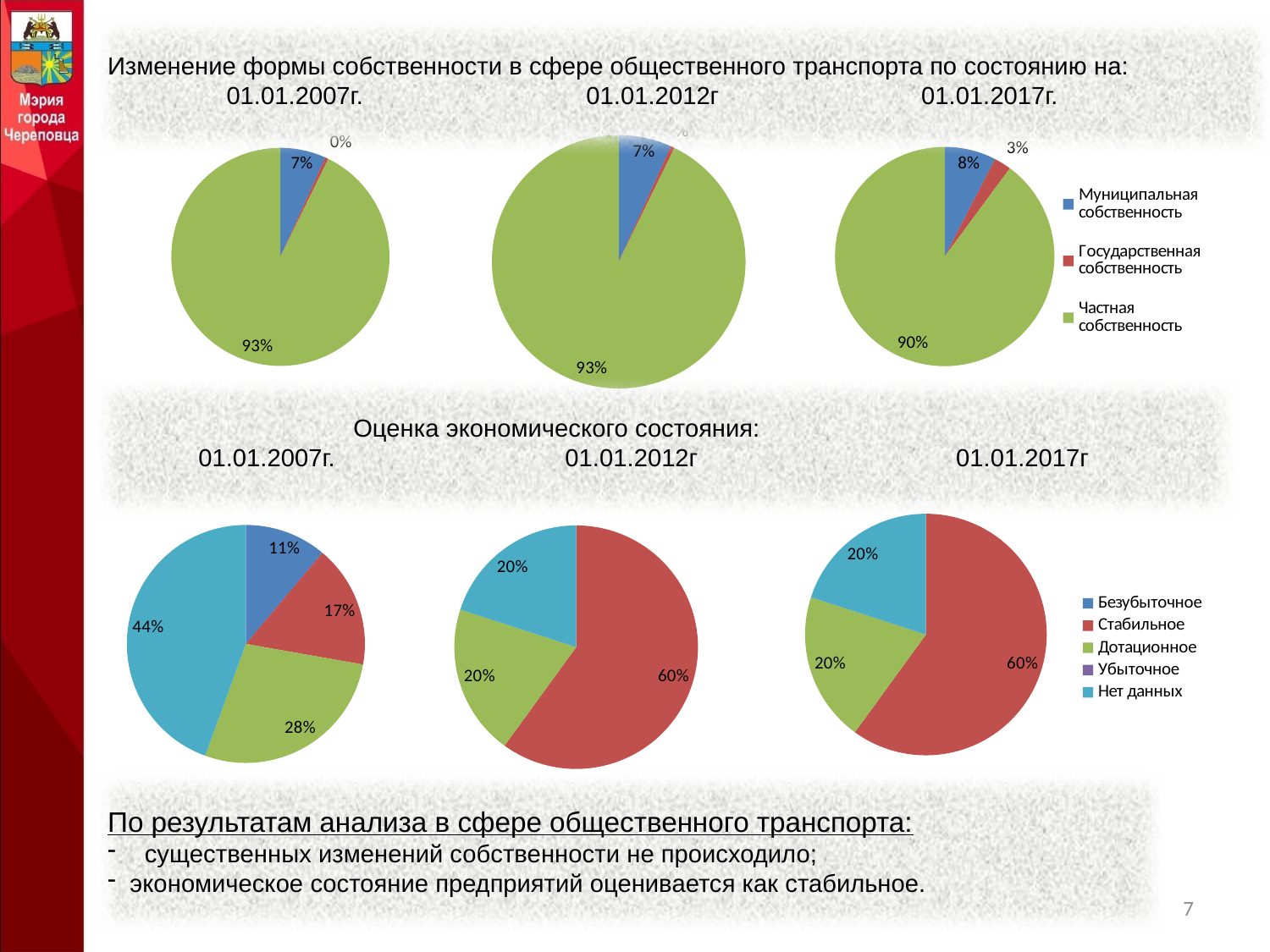
In the economic-condition pie chart for 01.01.2012, which category has the largest share? Стабильное How many entries does the legend of the economic-condition pie charts list? 5 In the ownership-form pie chart for 01.01.2007, what share is Муниципальная собственность? 7% In the economic-condition pie chart for 01.01.2007, what is the difference between the shares of Дотационное and Стабильное? 11% In the ownership-form pie chart for 01.01.2012, what share is Частная собственность? 93% In the economic-condition pie chart for 01.01.2017, which is larger: the share of Стабильное or the share of Дотационное? Стабильное In the ownership-form pie chart for 01.01.2017, what share is Частная собственность? 90% How many entries does the legend of the ownership-form pie charts list? 3 What type of chart is used for the economic-condition data on 01.01.2012? Pie chart In the ownership-form pie chart for 01.01.2017, what share is Государственная собственность? 3% In the economic-condition pie chart for 01.01.2007, what share is Нет данных? 44%